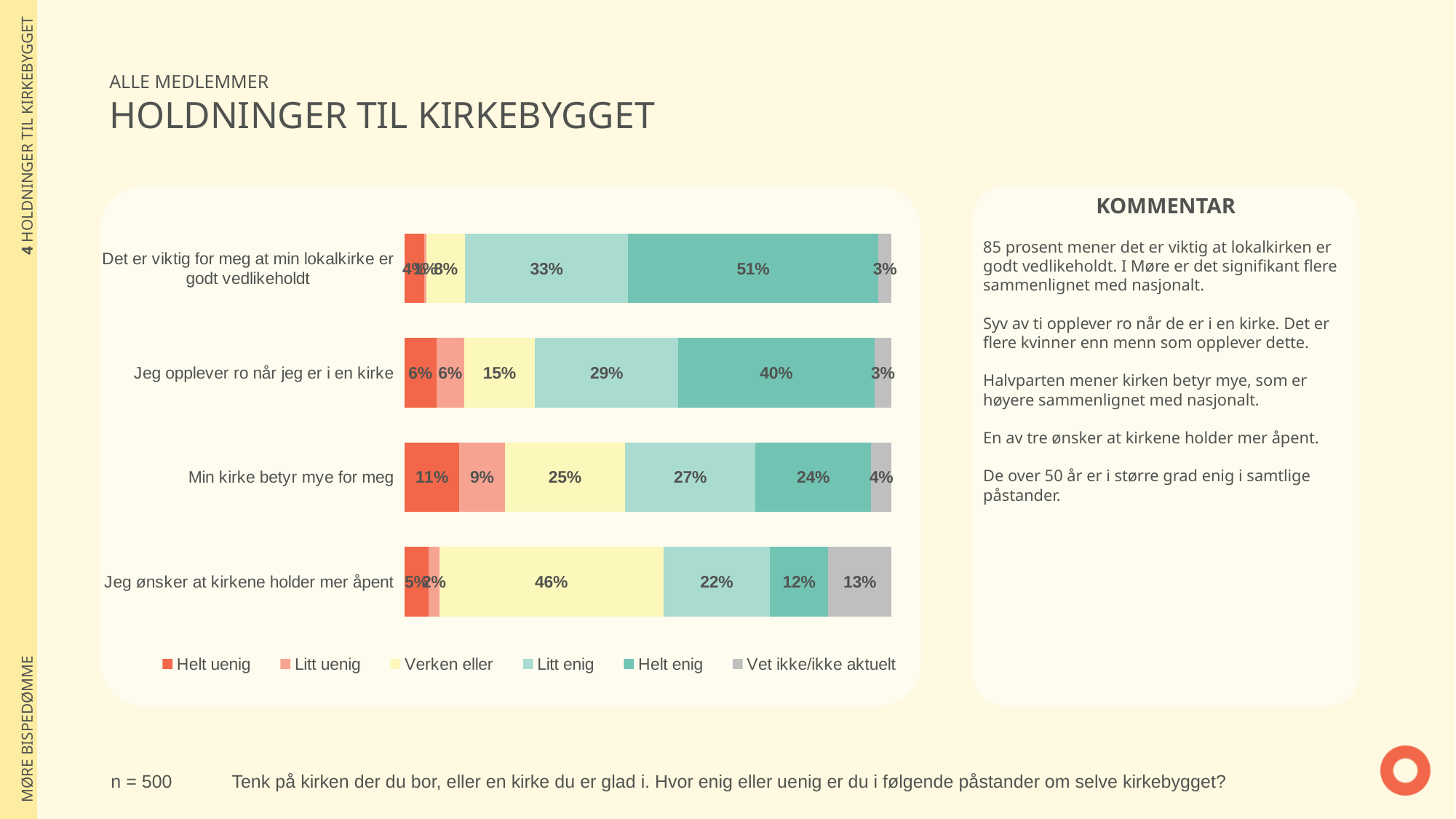
What is the 'Verken eller' value for 'Jeg ønsker at kirkene holder mer åpent'? 46% Which statement has the highest 'Helt uenig' share? Min kirke betyr mye for meg Which statement has the highest 'Helt enig' share? Det er viktig for meg at min lokalkirke er godt vedlikeholdt What is the 'Vet ikke/ikke aktuelt' value for 'Jeg ønsker at kirkene holder mer åpent'? 13% What is the 'Helt enig' value for 'Det er viktig for meg at min lokalkirke er godt vedlikeholdt'? 51% What is the 'Litt uenig' value for 'Min kirke betyr mye for meg'? 9% What is the 'Verken eller' value for 'Jeg opplever ro når jeg er i en kirke'? 15% How many statements (categories) are plotted in the chart? 4 What is the difference in 'Helt enig' between 'Jeg opplever ro når jeg er i en kirke' and 'Min kirke betyr mye for meg'? 16 percentage points Which is larger: the 'Helt enig' value for 'Jeg opplever ro når jeg er i en kirke' or for 'Jeg ønsker at kirkene holder mer åpent'? Jeg opplever ro når jeg er i en kirke How many series does the chart legend list? 6 What kind of chart is shown on the slide? Stacked bar chart